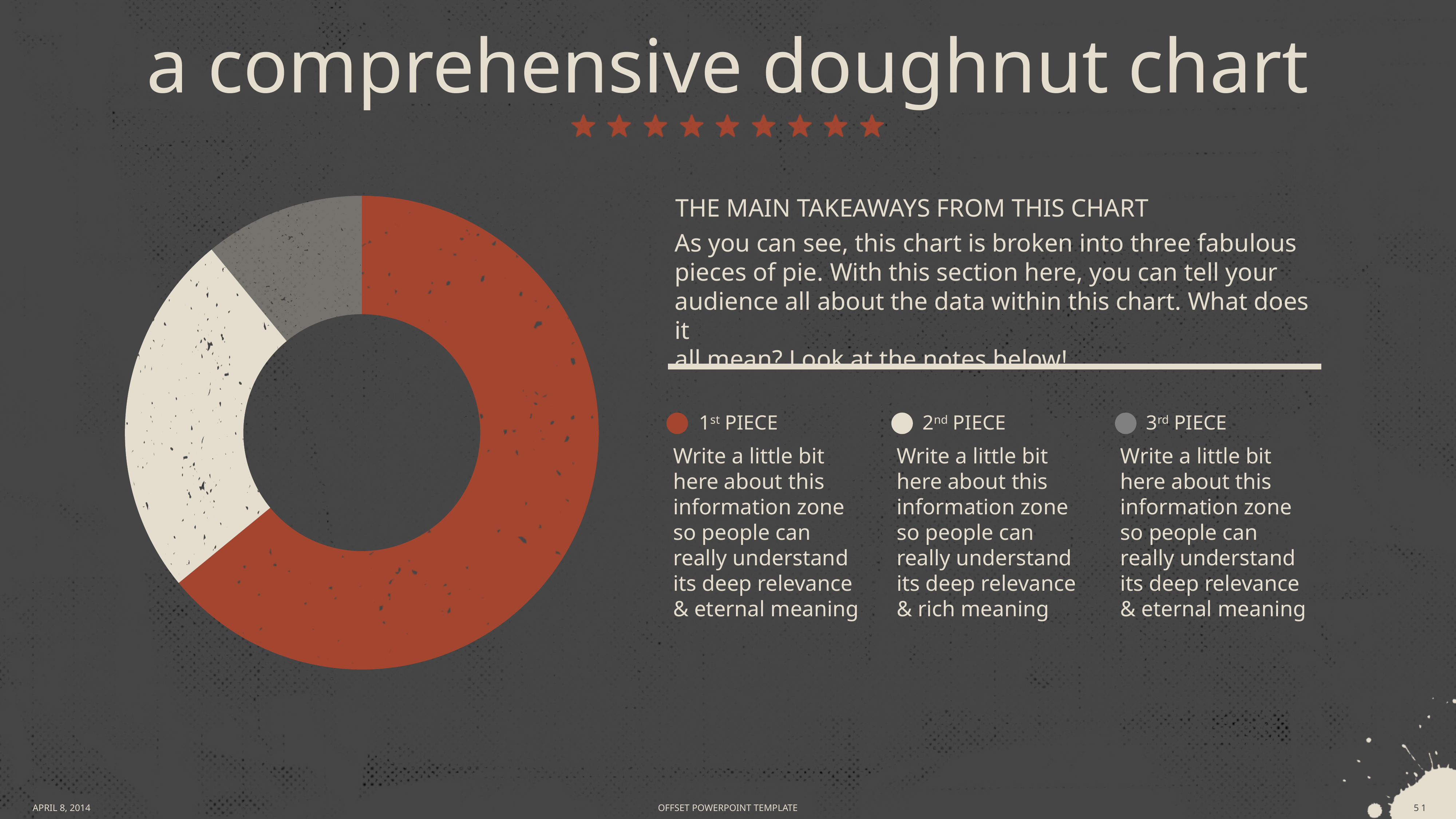
What kind of chart is shown on the slide? Doughnut chart How many pieces does the doughnut chart have? 3 Which piece of the doughnut chart is the largest? 1st PIECE Which is larger in the doughnut chart, the 1st PIECE or the 2nd PIECE? 1st PIECE Which piece of the doughnut chart is the smallest? 3rd PIECE How many entries does the chart's legend list? 3 What is the title of the slide containing the doughnut chart? a comprehensive doughnut chart Which is smaller in the doughnut chart, the 1st PIECE or the 3rd PIECE? 3rd PIECE What colour represents the 1st PIECE in the doughnut chart? Red Which is larger in the doughnut chart, the 2nd PIECE or the 3rd PIECE? 2nd PIECE